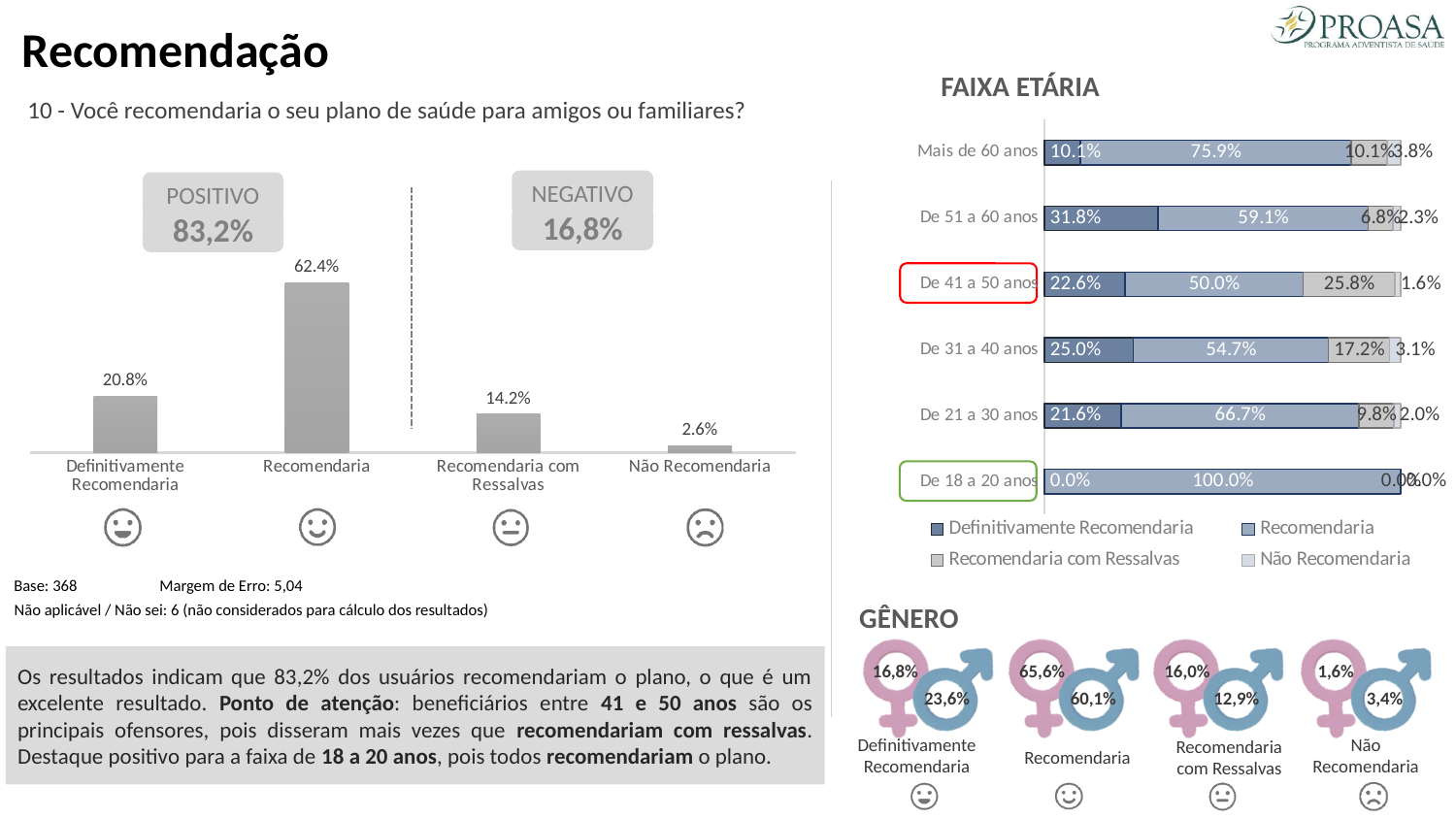
How many age groups are shown in the FAIXA ETÁRIA chart? 6 In the FAIXA ETÁRIA chart, which has the larger Definitivamente Recomendaria value: De 31 a 40 anos or De 21 a 30 anos? De 31 a 40 anos In the left chart (question 10), which category has the highest value? Recomendaria How many series does the legend of the FAIXA ETÁRIA chart list? 4 In the FAIXA ETÁRIA chart, what is the Recomendaria value for De 21 a 30 anos? 66.7% In the FAIXA ETÁRIA chart, what is the Definitivamente Recomendaria value for De 51 a 60 anos? 31.8% In the FAIXA ETÁRIA chart, which age group has the highest Recomendaria com Ressalvas value? De 41 a 50 anos In the left chart (question 10), what is the value for Recomendaria? 62.4% In the left chart (question 10), what is the difference between Definitivamente Recomendaria and Recomendaria com Ressalvas? 6.6 percentage points What kind of chart is the chart on the left of the slide, under question 10? Bar chart How many categories are shown in the left chart (question 10)? 4 In the left chart (question 10), which category has the lowest value? Não Recomendaria